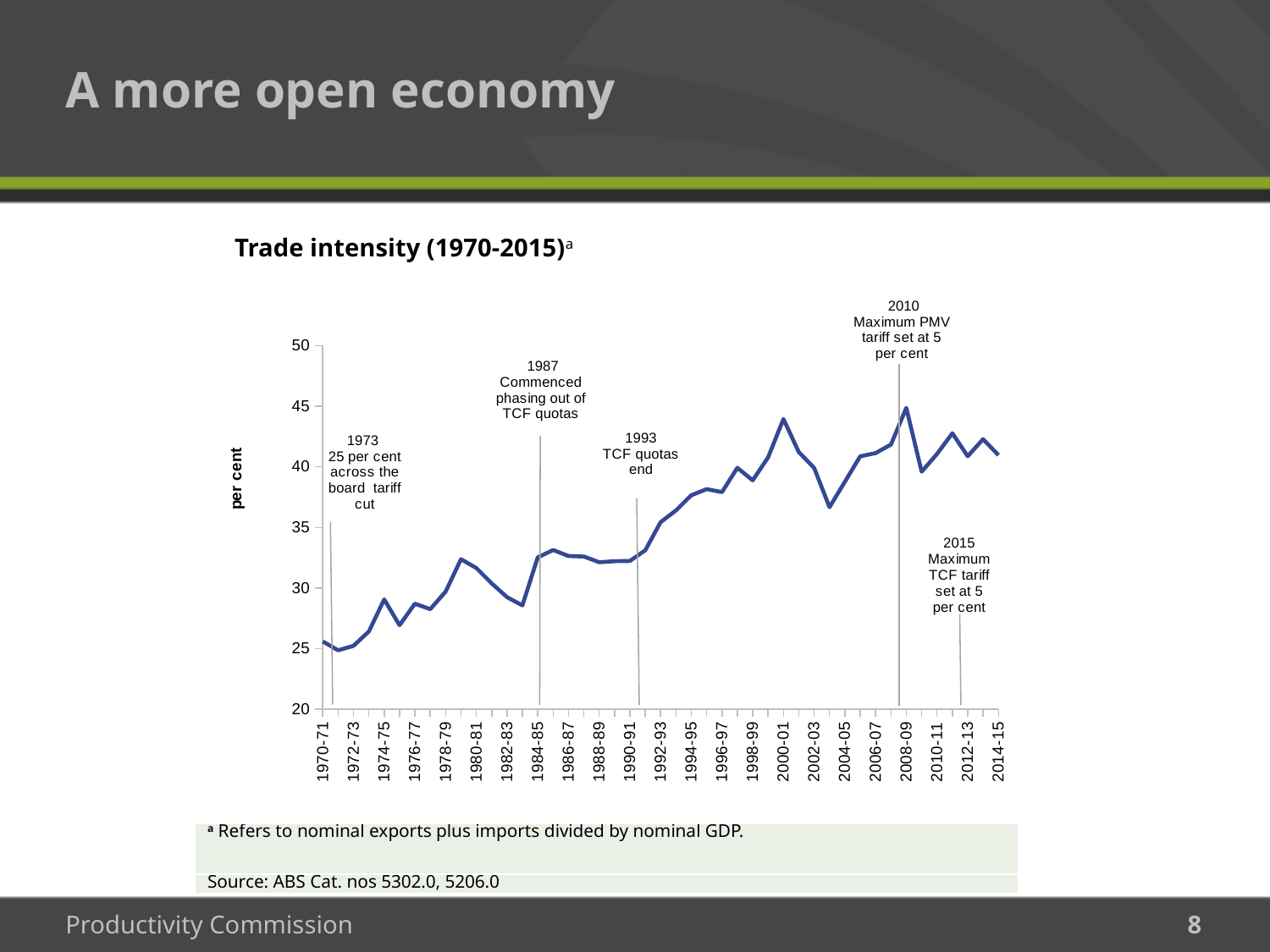
Is the value for 1984-85 greater or less than 30? greater Is the value for 1970-71 greater or less than 30? less Is the value for 1990-91 greater or less than 35? less Overall, does trade intensity rise or fall from 1970-71 to 2014-15? rise What kind of chart is shown on the slide? line chart What is the title of the chart? Trade intensity (1970-2015) Which is larger, the value for 2002-03 or the value for 2008-09? 2008-09 What is the label on the vertical axis of the chart? per cent Which is larger, the value for 2000-01 or the value for 1970-71? 2000-01